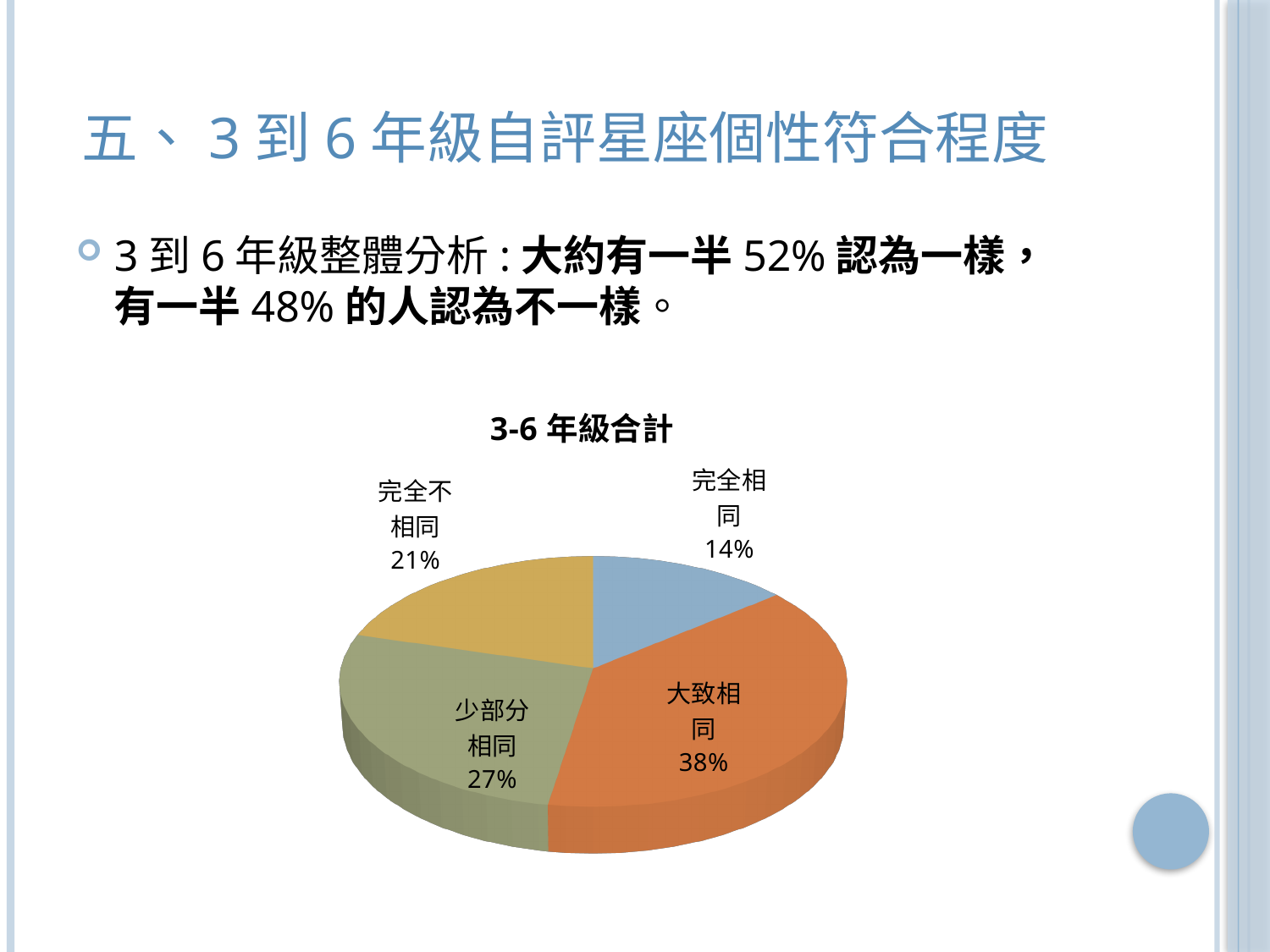
What kind of chart is shown on the slide? pie chart How many slices does the pie chart have? 4 Which category has the largest share of the pie? 大致相同 What percentage is shown for 少部分相同? 27% What colour is the 大致相同 slice? orange What percentage is shown for 完全不相同? 21% What is the difference in percentage points between 大致相同 and 完全相同? 24 Which category has the smallest share of the pie? 完全相同 What percentage is shown for 完全相同? 14% What is the title of the chart? 3-6 年級合計 What percentage is shown for 大致相同? 38% Which is larger, the share for 少部分相同 or the share for 完全不相同? 少部分相同